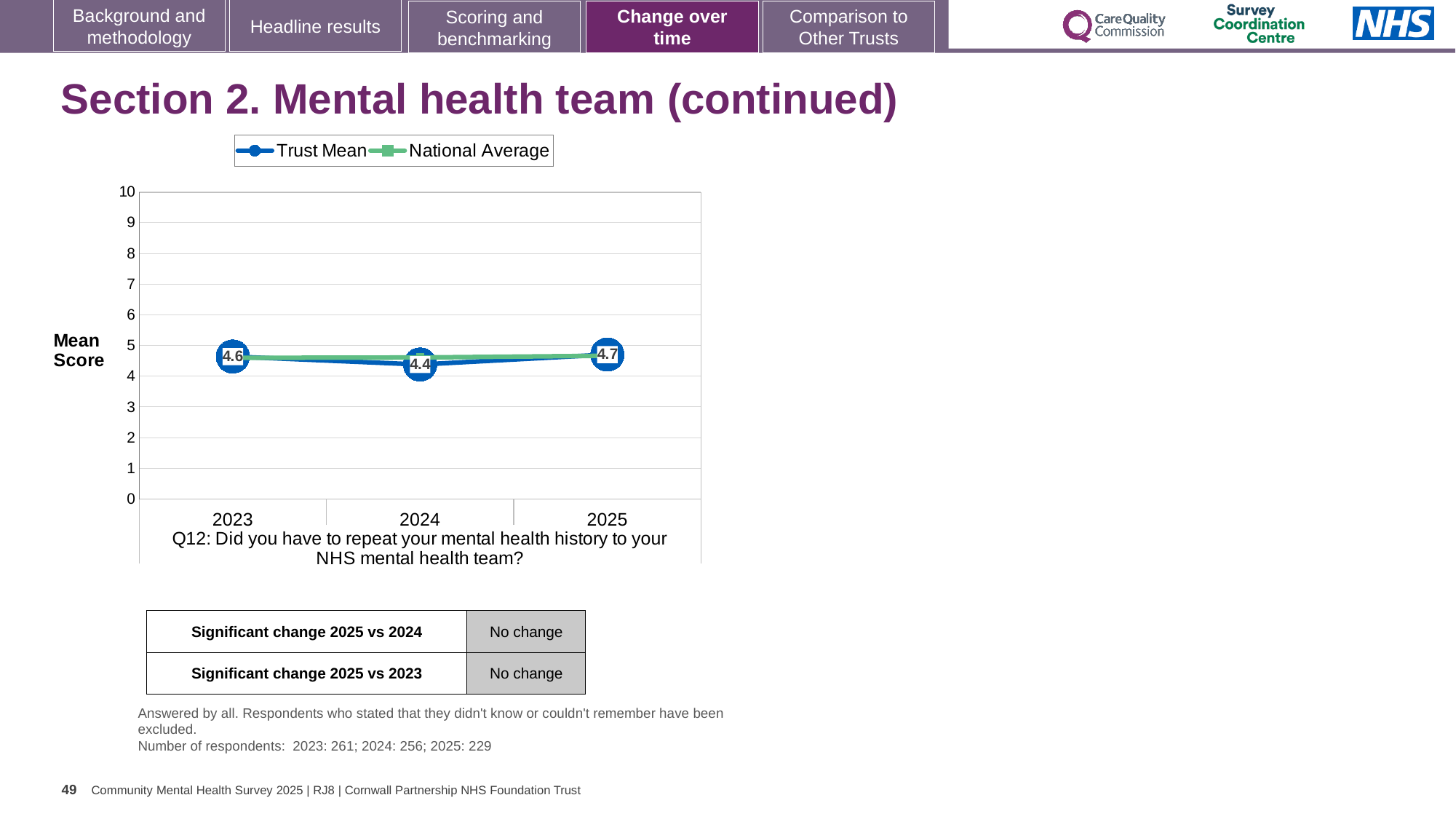
What is the Trust Mean score for 2023? 4.6 How many series does the legend list? 2 Is the Trust Mean for 2024 greater or less than 5? less Does the Trust Mean rise or fall from 2024 to 2025? rise Is the Trust Mean higher in 2023 or in 2025? 2025 What kind of chart is shown on the slide? line chart In which year is the Trust Mean lowest? 2024 What is the Trust Mean score for 2025? 4.7 What is the difference between the Trust Mean in 2025 and in 2024? 0.3 In which year is the Trust Mean highest? 2025 How many years are plotted on the x axis? 3 What is the Trust Mean score for 2024? 4.4